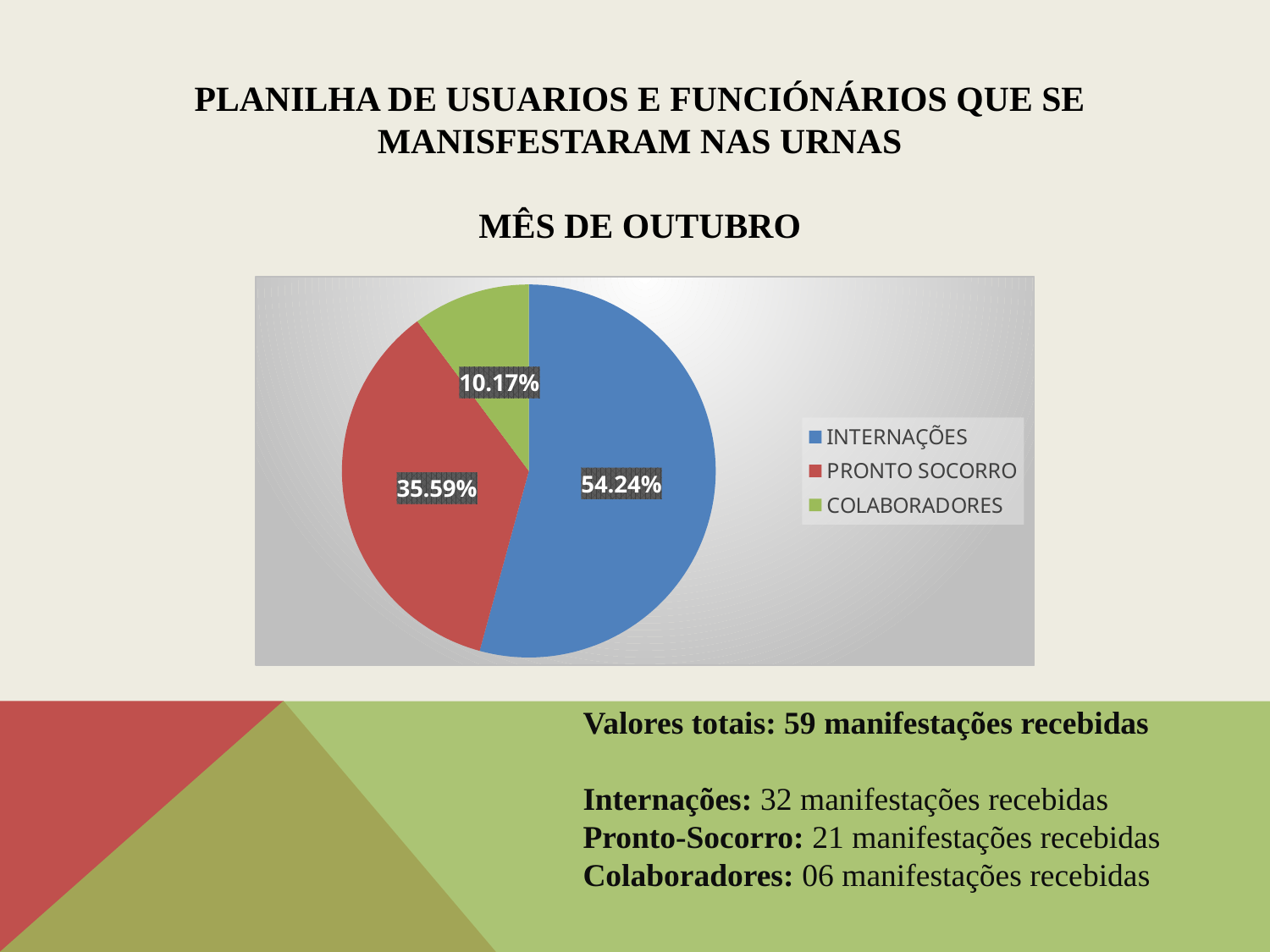
How many slices does the pie chart have? 3 What share of the pie does INTERNAÇÕES represent? 54.24% What share of the pie does PRONTO SOCORRO represent? 35.59% Which is larger, the slice for PRONTO SOCORRO or the slice for COLABORADORES? PRONTO SOCORRO Which category has the largest slice of the pie? INTERNAÇÕES How many entries does the legend list? 3 What colour is the slice for PRONTO SOCORRO? red What is the difference in percentage points between the INTERNAÇÕES slice and the PRONTO SOCORRO slice? 18.65% What share of the pie does COLABORADORES represent? 10.17% Which category has the smallest slice of the pie? COLABORADORES What colour is the slice for COLABORADORES? green What type of chart is shown on the slide? pie chart